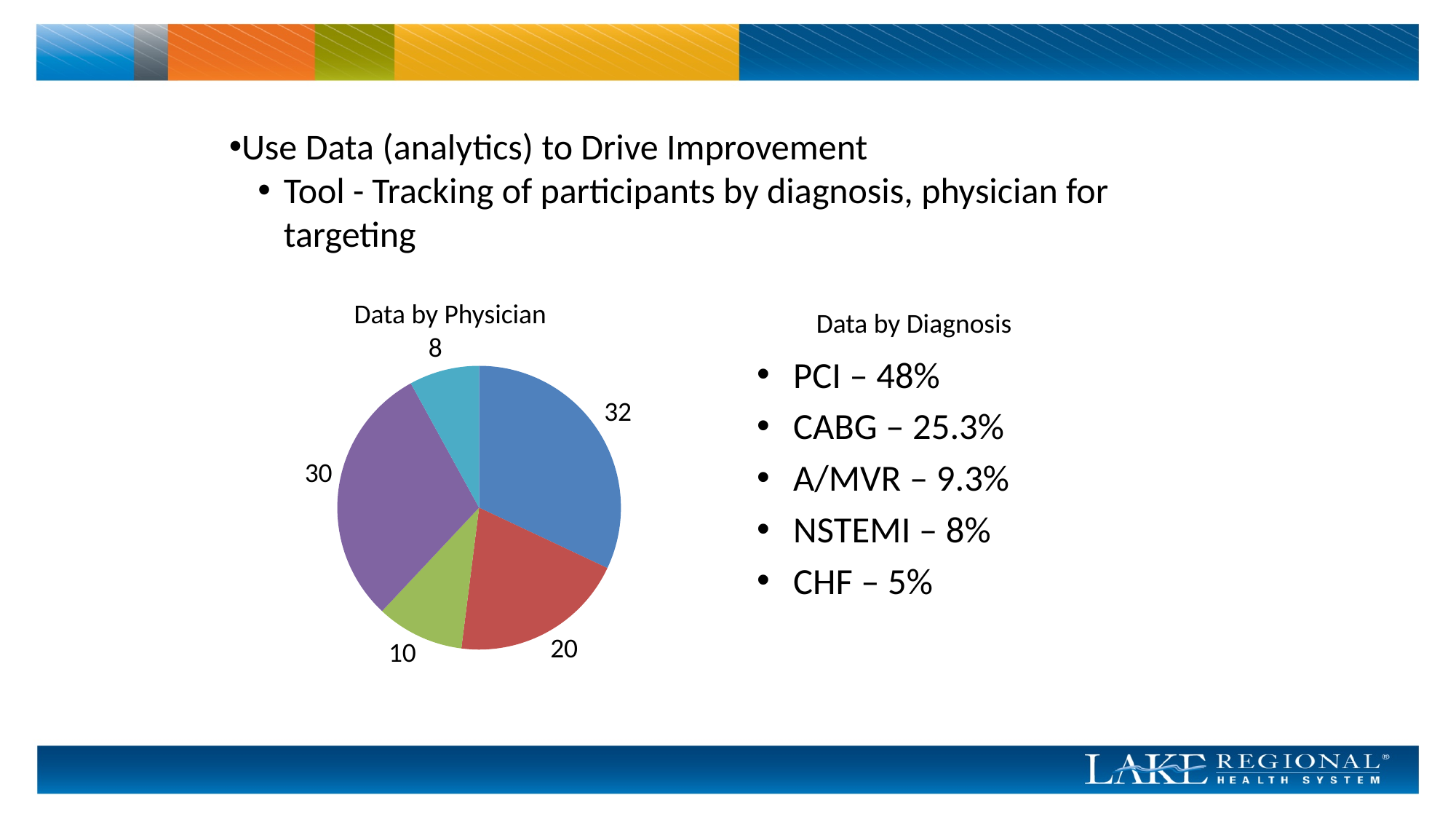
What is the difference between the largest and smallest slice values in the Data by Physician pie chart? 24 What is the value of the green slice in the Data by Physician pie chart? 10 What is the total of all slice values in the Data by Physician pie chart? 100 What is the value of the blue slice in the Data by Physician pie chart? 32 What is the title of the pie chart? Data by Physician What is the value of the purple slice in the Data by Physician pie chart? 30 How many slices does the Data by Physician pie chart have? 5 What kind of chart is shown on the slide? pie chart What is the largest value shown on the Data by Physician pie chart? 32 What share of the Data by Physician pie does the slice labelled 20 represent? 20% What is the smallest value shown on the Data by Physician pie chart? 8 Which slice is larger in the Data by Physician pie chart, the red slice or the green slice? the red slice